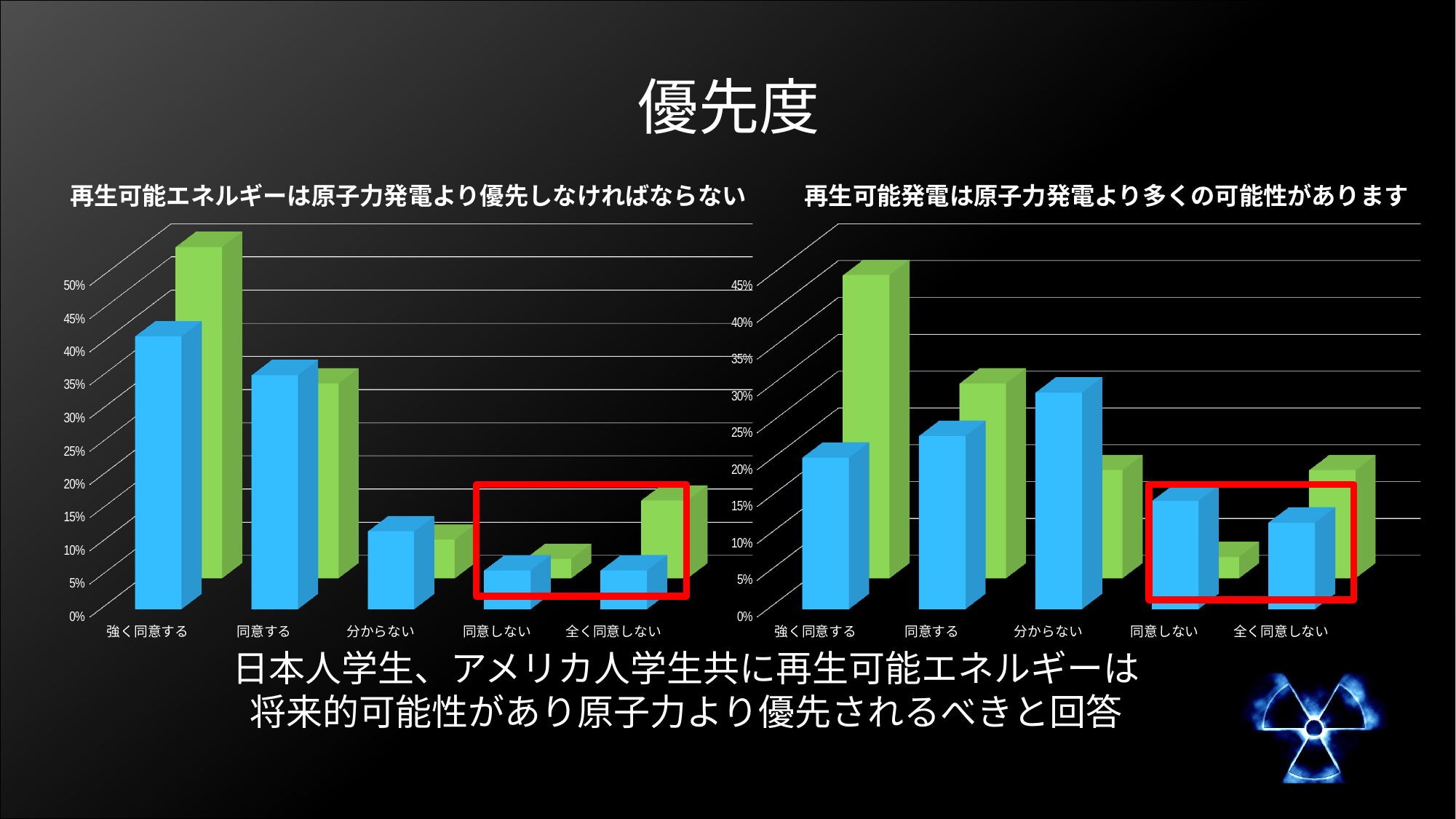
In the left chart (再生可能エネルギーは原子力発電より優先しなければならない), which category has the shortest green bar? 同意しない In the left chart (再生可能エネルギーは原子力発電より優先しなければならない), is the blue bar for 分からない greater or less than 20%? less What kind of chart is the left chart titled 再生可能エネルギーは原子力発電より優先しなければならない? Bar chart In the left chart (再生可能エネルギーは原子力発電より優先しなければならない), which category has the tallest green bar? 強く同意する In the right chart (再生可能発電は原子力発電より多くの可能性があります), which category has the shortest green bar? 同意しない In the right chart (再生可能発電は原子力発電より多くの可能性があります), which category has the tallest blue bar? 分からない In the left chart (再生可能エネルギーは原子力発電より優先しなければならない), is the green bar for 強く同意する greater or less than 45%? greater How many categories are shown on the x axis of the right chart titled 再生可能発電は原子力発電より多くの可能性があります? 5 In the right chart (再生可能発電は原子力発電より多くの可能性があります), for 同意しない, is the blue bar or the green bar taller? blue In the right chart (再生可能発電は原子力発電より多くの可能性があります), which category has the tallest green bar? 強く同意する In the right chart (再生可能発電は原子力発電より多くの可能性があります), is the green bar for 強く同意する greater or less than 40%? greater In the left chart (再生可能エネルギーは原子力発電より優先しなければならない), for 強く同意する, is the blue bar or the green bar taller? green